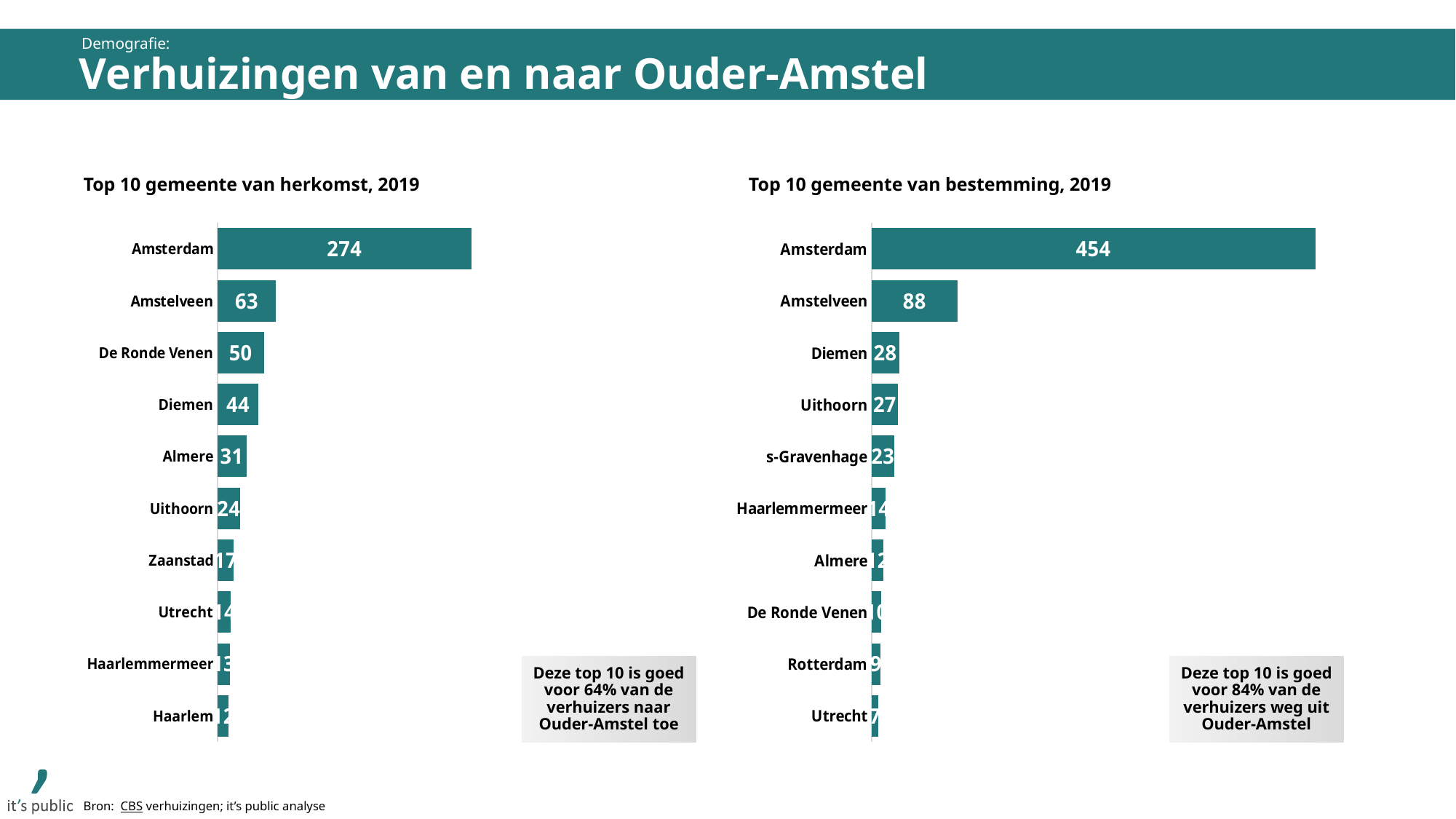
In the 'Top 10 gemeente van bestemming, 2019' chart, what is the difference between Diemen and Uithoorn? 1 In the 'Top 10 gemeente van bestemming, 2019' chart, what is the value for Amstelveen? 88 In the 'Top 10 gemeente van herkomst, 2019' chart, what is the difference between Amsterdam and Amstelveen? 211 Which is larger: Diemen in the 'Top 10 gemeente van herkomst, 2019' chart or Diemen in the 'Top 10 gemeente van bestemming, 2019' chart? Diemen in the herkomst chart (44) According to the text box next to the 'Top 10 gemeente van bestemming, 2019' chart, what share of movers away from Ouder-Amstel does this top 10 account for? 84% In the 'Top 10 gemeente van herkomst, 2019' chart, what is the value for Amsterdam? 274 In the 'Top 10 gemeente van bestemming, 2019' chart, which municipality has the highest value? Amsterdam How many municipalities are shown in the 'Top 10 gemeente van bestemming, 2019' chart? 10 In the 'Top 10 gemeente van herkomst, 2019' chart, what is the value for De Ronde Venen? 50 What type of chart is the 'Top 10 gemeente van herkomst, 2019' chart? Bar chart In the 'Top 10 gemeente van bestemming, 2019' chart, what is the value for s-Gravenhage? 23 In the 'Top 10 gemeente van herkomst, 2019' chart, which municipality has the lowest value? Haarlem